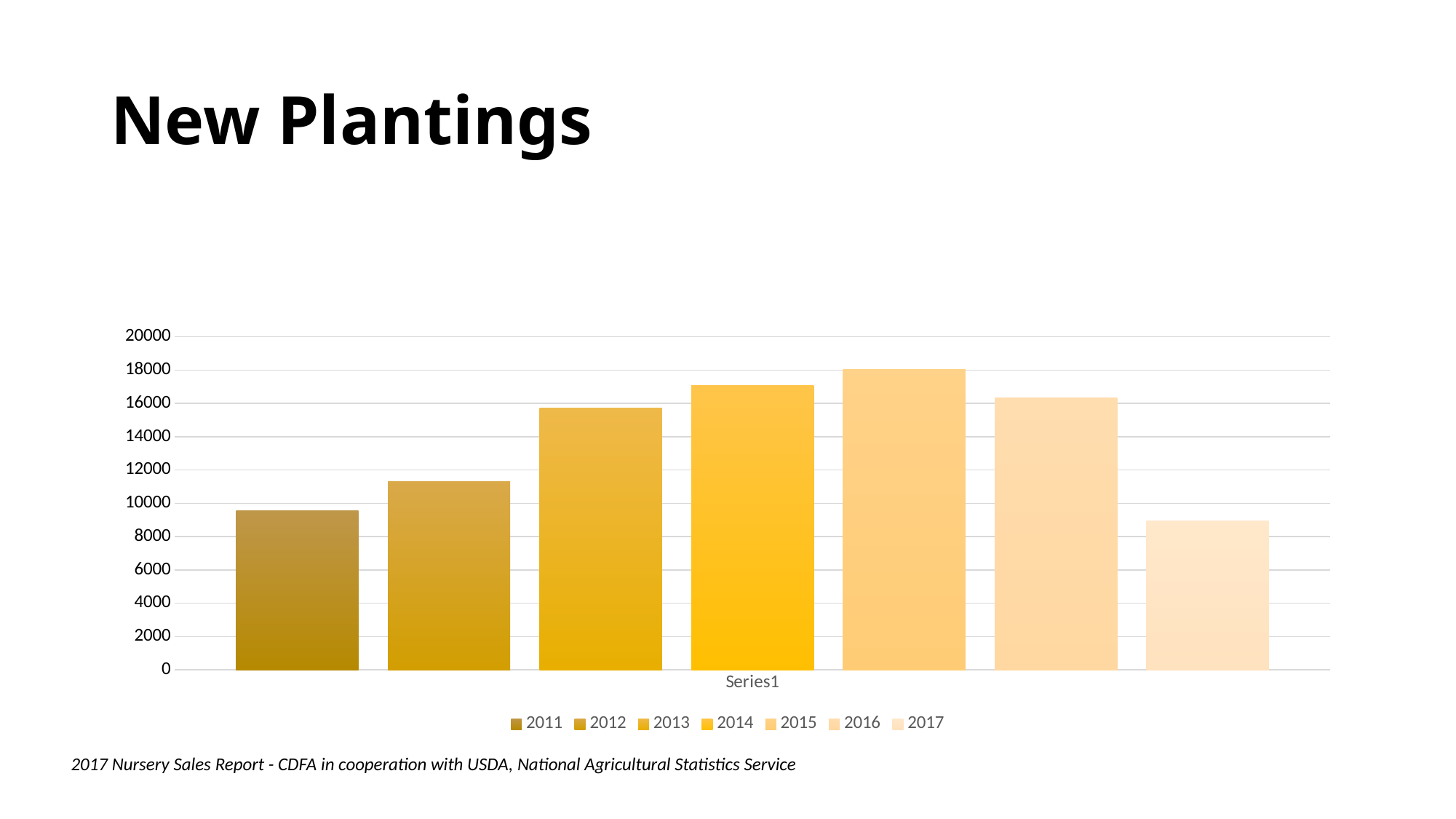
Is the value for 2016 greater or less than 18000? less What kind of chart is shown on the slide? bar chart Which is larger, the value for 2014 or the value for 2012? 2014 Is the value for 2011 greater or less than 10000? less Is the value for 2017 greater or less than 10000? less Do the values rise or fall from 2011 to 2015? rise What is the title of the chart? New Plantings How many series does the legend list? 7 Which year has the highest value? 2015 Which year has the lowest value? 2017